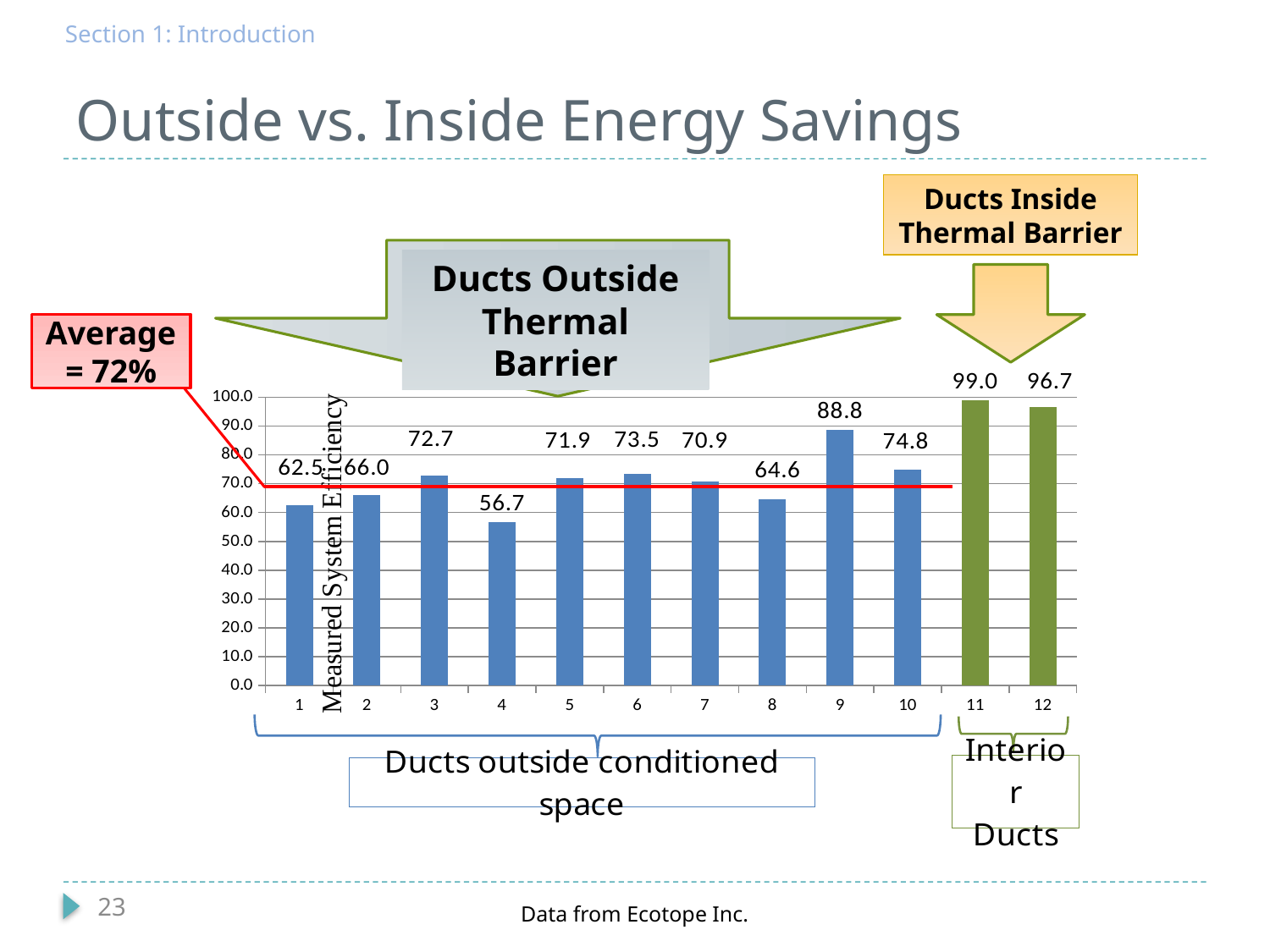
Is the value for category 10 greater or less than 70.0? greater What is the difference between the values for category 9 and category 4? 32.1 What is the difference between the values for category 11 and category 12? 2.3 What is the Measured System Efficiency value for category 4? 56.7 Which category has the lowest value in the chart? 4 What type of chart is shown on the slide? bar chart How many bars (categories) are plotted in the chart? 12 What is the value shown for category 11? 99.0 What is the label on the vertical axis of the chart? Measured System Efficiency Which category has the highest value in the chart? 11 Which is larger, the value for category 3 or the value for category 8? category 3 What is the value shown for category 9? 88.8